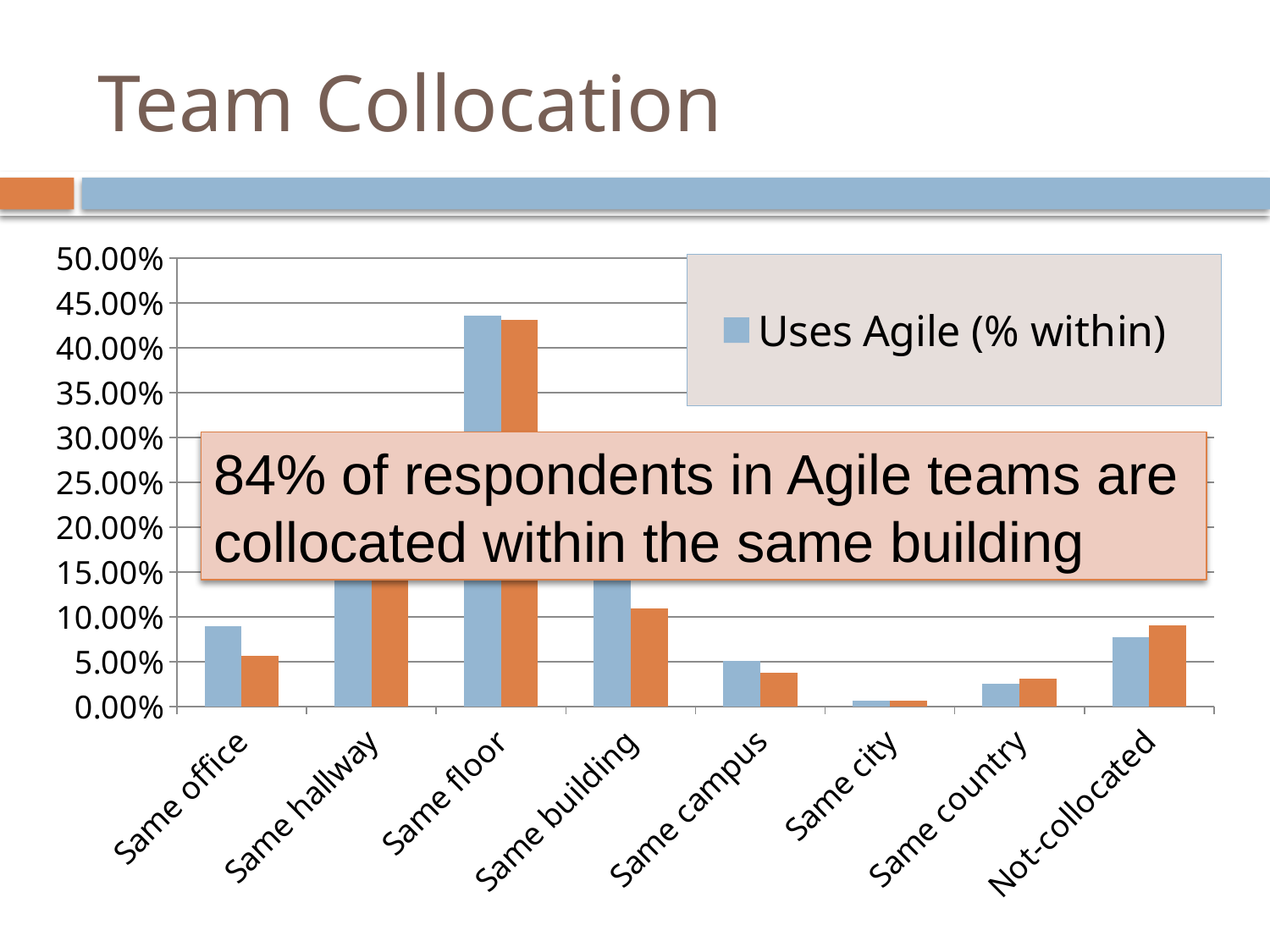
What series name is shown in the chart legend? Uses Agile (% within) Which category has the lowest value for the Uses Agile (% within) series? Same city For Not-collocated, which bar is taller, the blue Uses Agile (% within) bar or the orange bar? the orange bar Is the Uses Agile (% within) value for Same floor greater or less than 40.00%? greater Is the Uses Agile (% within) value for Same country greater or less than 5.00%? less What kind of chart is shown on the slide? bar chart For Same office, which series has the larger value, the blue Uses Agile (% within) series or the orange series? Uses Agile (% within) Is the Uses Agile (% within) value for Same office greater or less than 10.00%? less What is the title of the slide containing the chart? Team Collocation Which category has the highest value for the Uses Agile (% within) series? Same floor How many collocation categories are shown on the x axis? 8